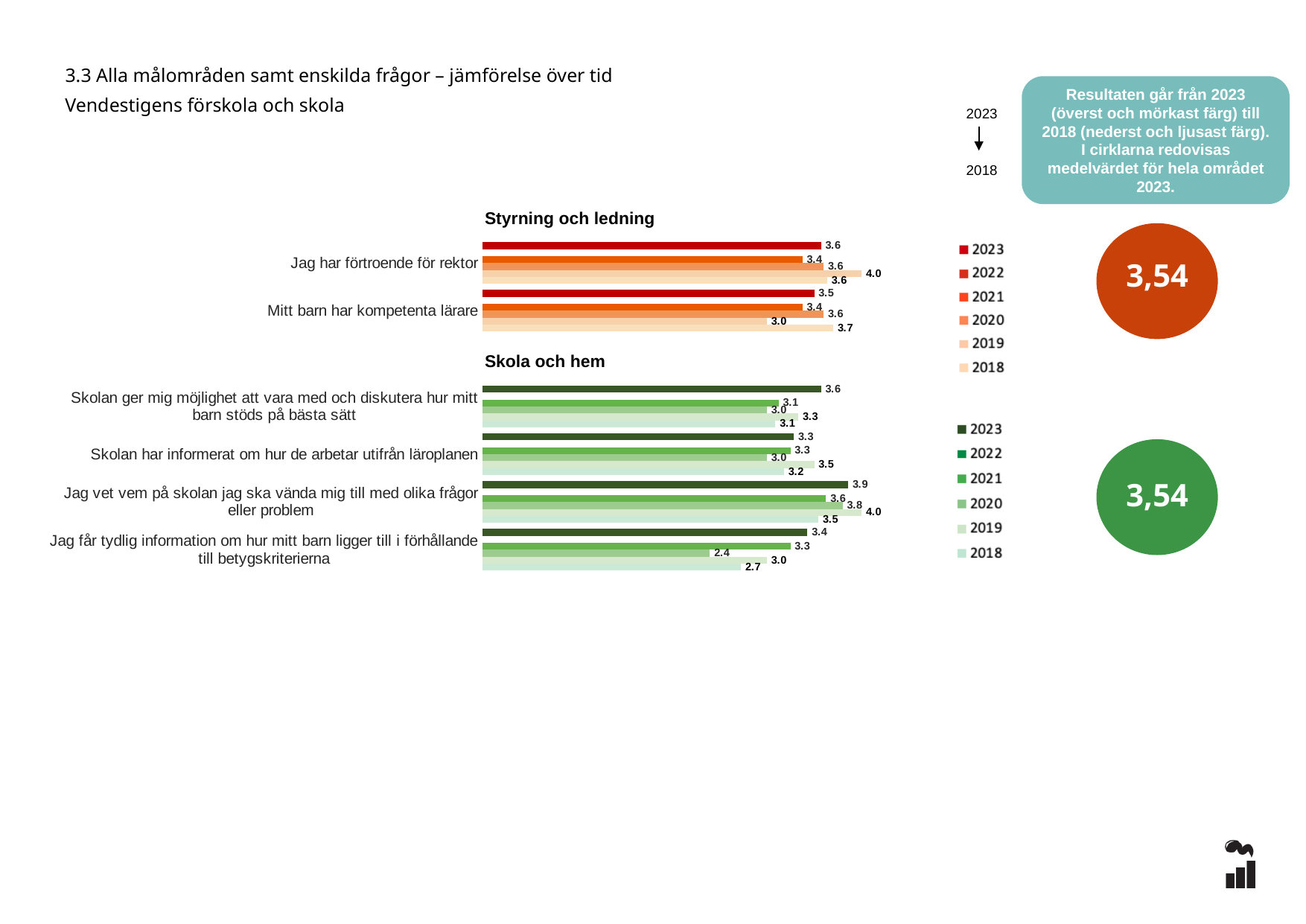
How many questions are shown in the 'Styrning och ledning' chart? 2 In the 'Skola och hem' chart, what is the difference between the 2023 values for 'Jag vet vem på skolan jag ska vända mig till med olika frågor eller problem' and 'Skolan har informerat om hur de arbetar utifrån läroplanen'? 0.6 In the 'Skola och hem' chart, what is the 2023 value for 'Jag vet vem på skolan jag ska vända mig till med olika frågor eller problem'? 3.9 In the 'Styrning och ledning' chart, what is the 2023 value for 'Jag har förtroende för rektor'? 3.6 In the 'Skola och hem' chart, what is the lowest value shown for any year? 2.4 In the 'Styrning och ledning' chart, what is the 2023 value for 'Mitt barn har kompetenta lärare'? 3.5 What mean value is shown in the circle next to the 'Skola och hem' chart? 3,54 How many questions are shown in the 'Skola och hem' chart? 4 In the 'Skola och hem' chart, which question has the highest 2023 value? Jag vet vem på skolan jag ska vända mig till med olika frågor eller problem In the 'Skola och hem' chart, which question has the lowest 2023 value? Skolan har informerat om hur de arbetar utifrån läroplanen What kind of chart is used on this slide to show the results for each question? Bar chart How many years does the legend of the 'Skola och hem' chart list? 6